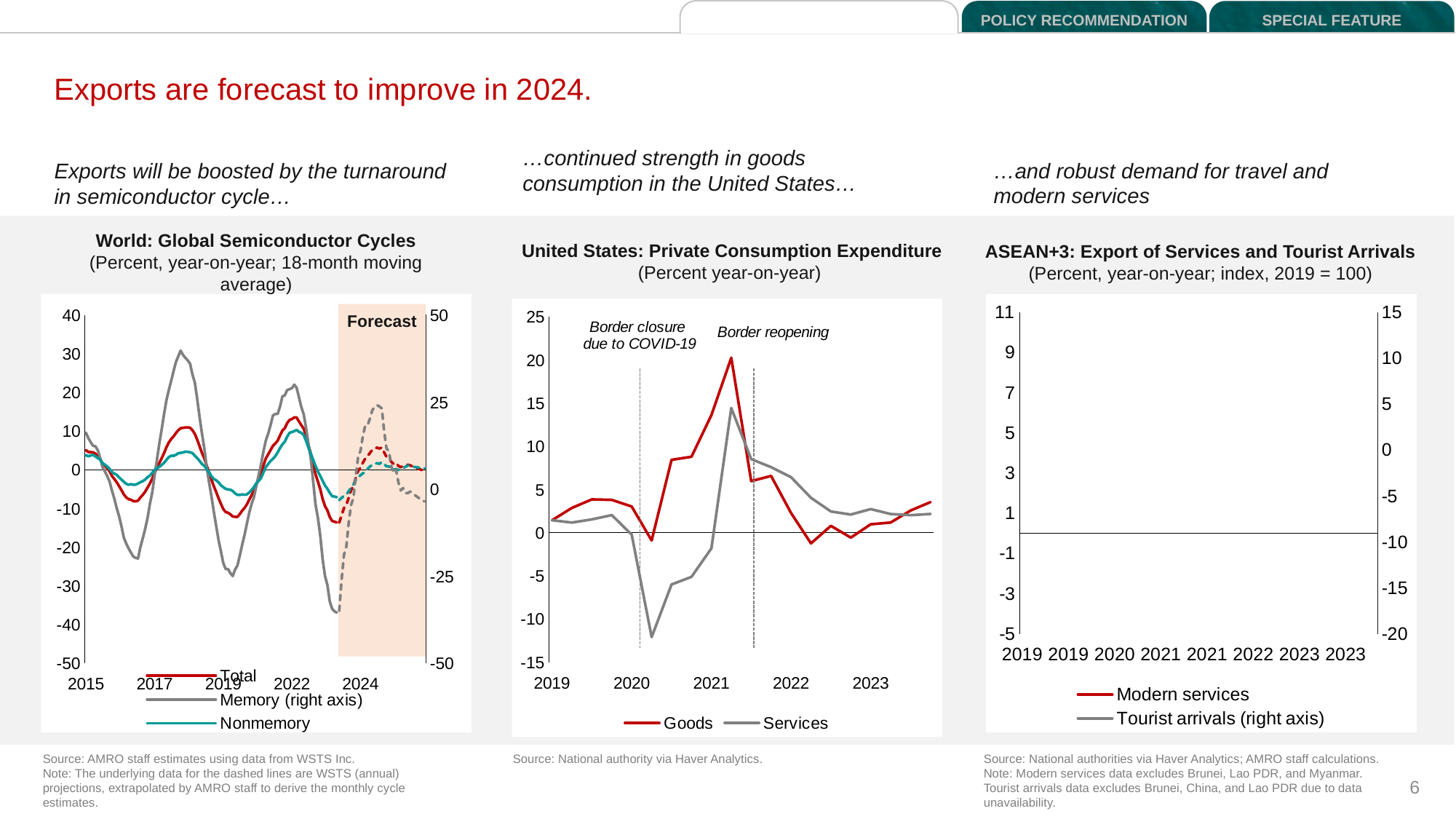
How many series does the legend of 'World: Global Semiconductor Cycles' list? 3 In 'World: Global Semiconductor Cycles', what label is shown on the shaded region at the right of the chart? Forecast How many series does the legend of 'United States: Private Consumption Expenditure' list? 2 In 'United States: Private Consumption Expenditure', is the peak value of Goods in 2021 greater or less than 15? greater How many series does the legend of 'ASEAN+3: Export of Services and Tourist Arrivals' list? 2 In 'United States: Private Consumption Expenditure', which series reaches the higher peak in 2021, Goods or Services? Goods In 'United States: Private Consumption Expenditure', does the Goods line rise or fall from its 2021 peak to 2022? fall In 'World: Global Semiconductor Cycles', which series is plotted on the right axis? Memory What kind of chart is 'United States: Private Consumption Expenditure'? line chart In 'World: Global Semiconductor Cycles', is the lowest value of the Memory series (right axis) around 2023 greater or less than -25? less In 'United States: Private Consumption Expenditure', is the lowest value of Services in 2020 greater or less than -10? less What kind of chart is 'World: Global Semiconductor Cycles'? line chart